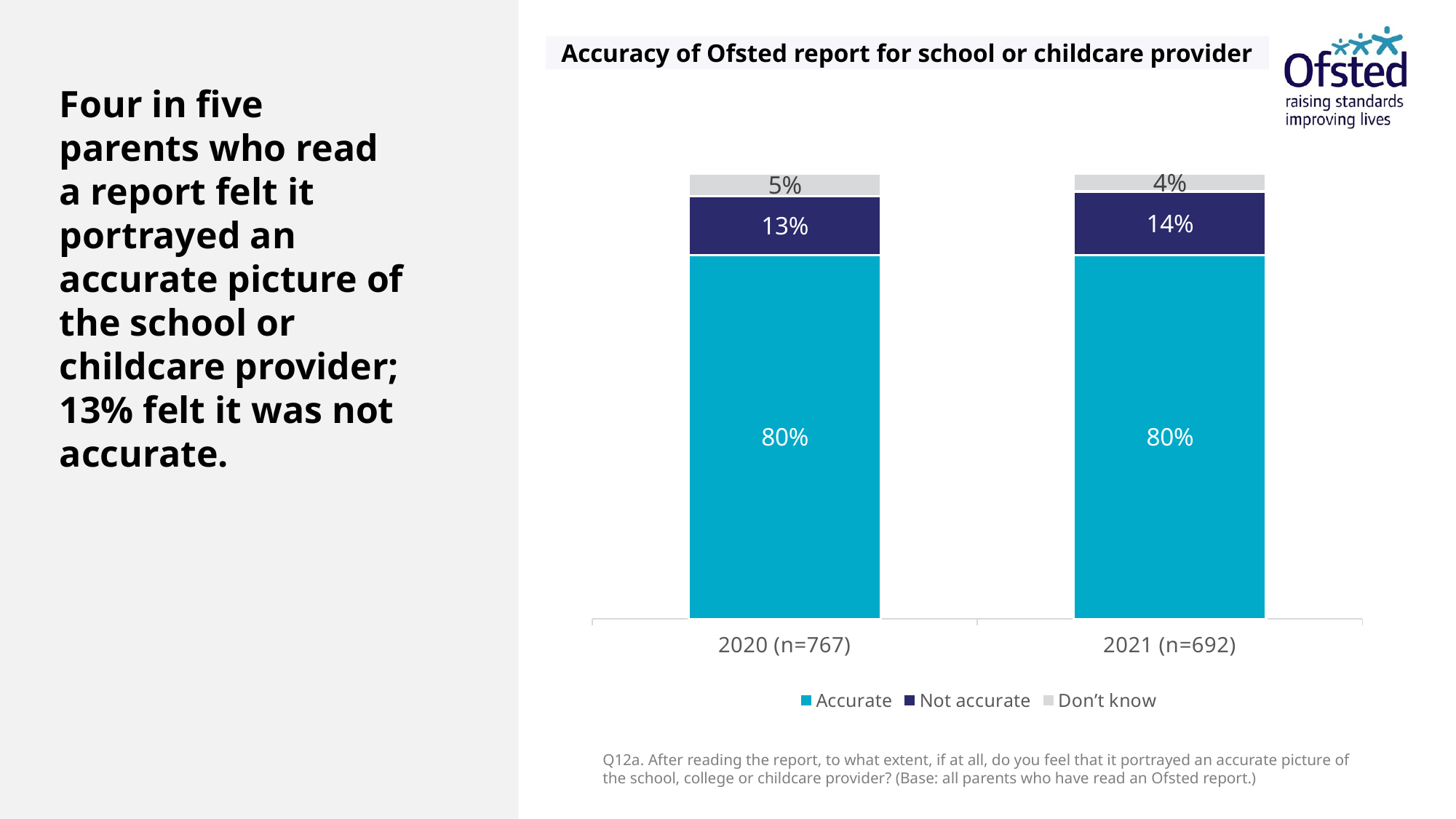
What is the difference between the Not accurate values for 2021 (n=692) and 2020 (n=767)? 1% How many series does the legend list? 3 What is the title of the chart? Accuracy of Ofsted report for school or childcare provider What percentage of parents in 2021 (n=692) felt the report was Not accurate? 14% What percentage of parents in 2020 (n=767) felt the report was Accurate? 80% Which year has the higher Not accurate percentage? 2021 (n=692) What kind of chart is shown? Stacked bar chart What is the total of the stacked bar for 2021 (n=692)? 98% What is the Don't know value for 2020 (n=767)? 5% How many categories are shown on the x axis? 2 What is the Don't know value for 2021 (n=692)? 4% What is the total of the stacked bar for 2020 (n=767)? 98%